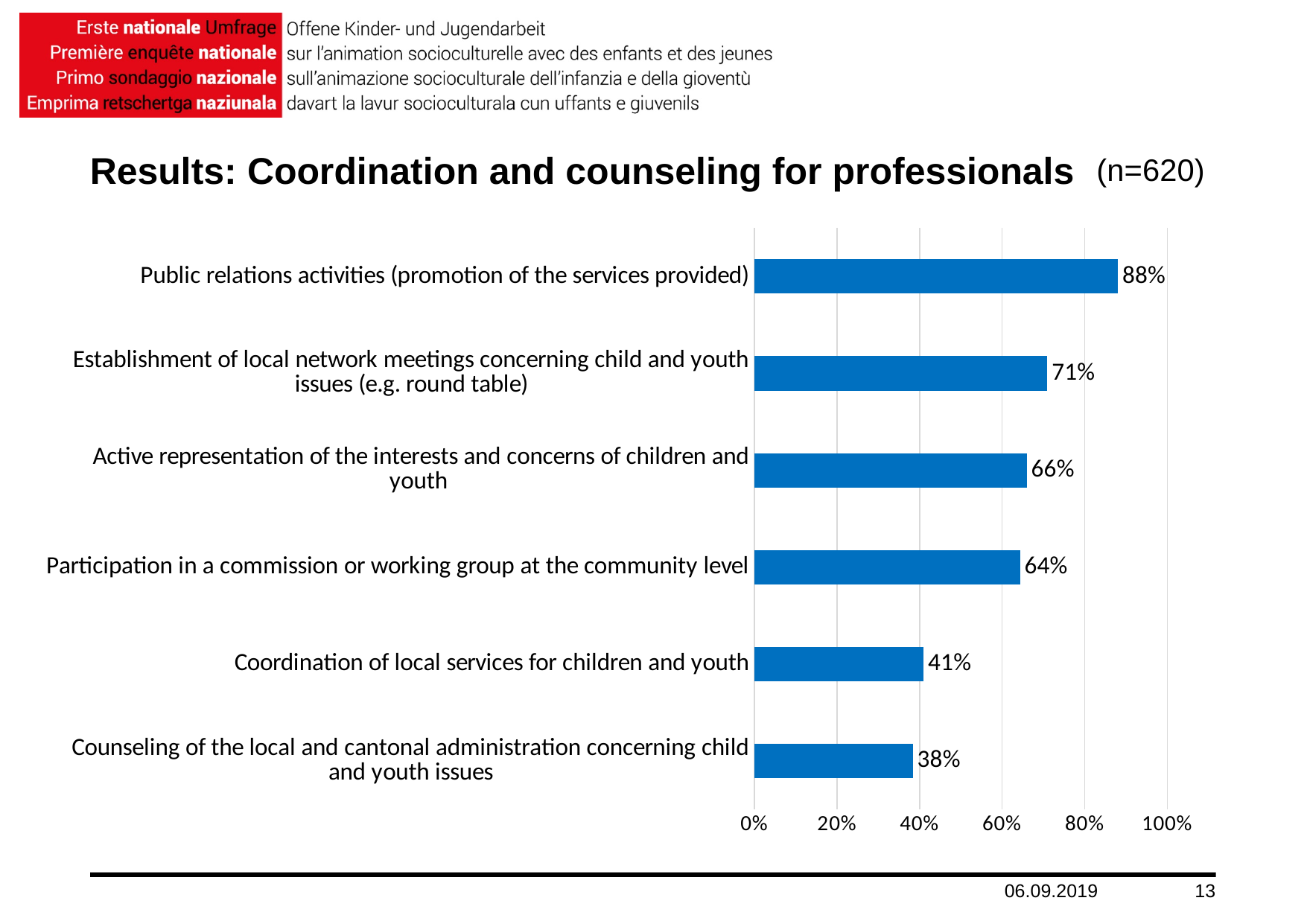
Which category has the highest value? Public relations activities (promotion of the services provided) Is the value for Establishment of local network meetings concerning child and youth issues greater or less than 60%? greater What is the value for Public relations activities (promotion of the services provided)? 88% What is the difference between the values for Public relations activities and Establishment of local network meetings concerning child and youth issues? 17% What is the value for Counseling of the local and cantonal administration concerning child and youth issues? 38% What is the value for Participation in a commission or working group at the community level? 64% Which is larger: the value for Active representation of the interests and concerns of children and youth or the value for Coordination of local services for children and youth? Active representation of the interests and concerns of children and youth What is the value for Coordination of local services for children and youth? 41% What kind of chart is shown on the slide? Bar chart How many categories are shown in the chart? 6 Which category has the lowest value? Counseling of the local and cantonal administration concerning child and youth issues What is the sample size (n) stated next to the slide title? n=620